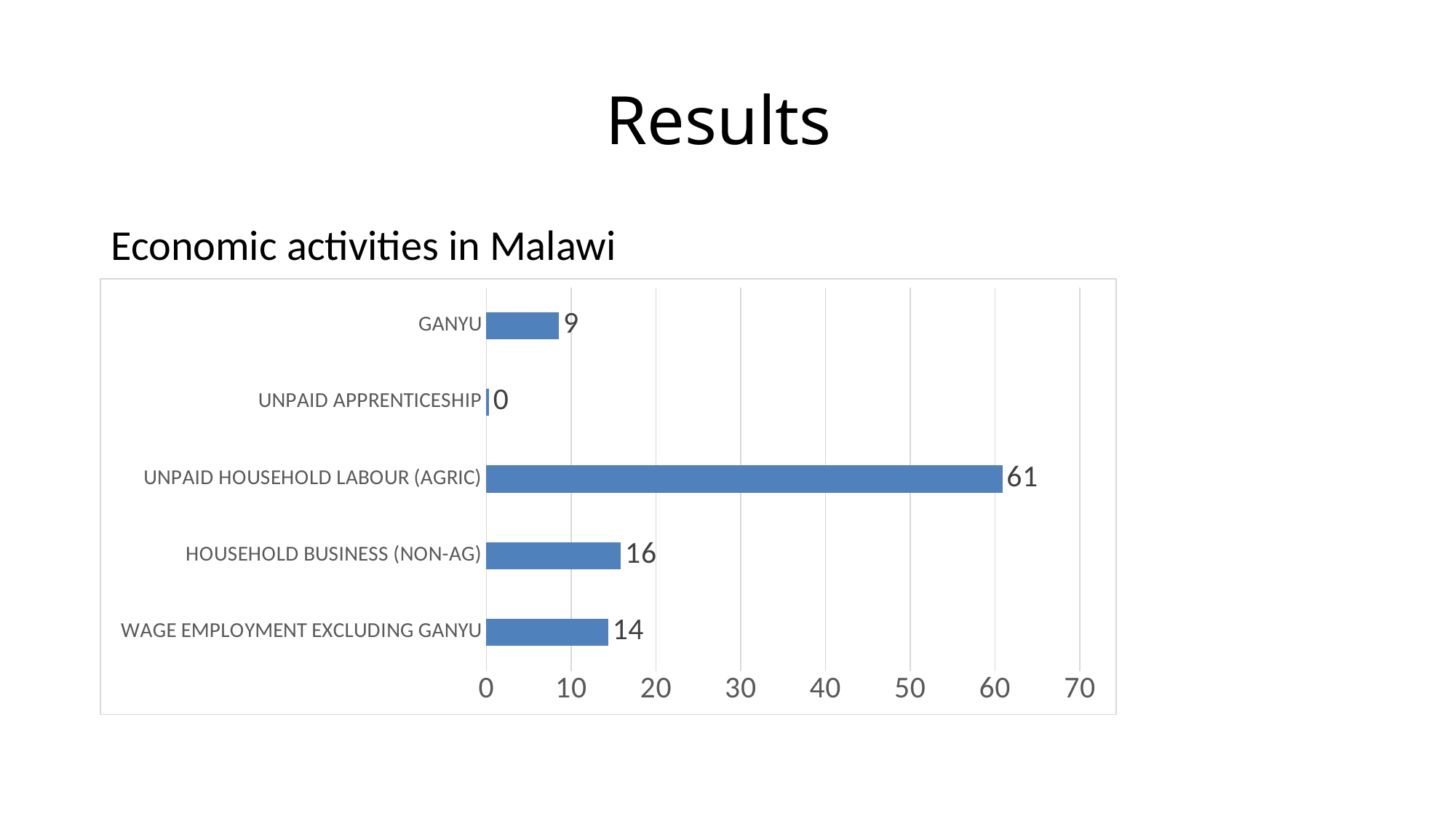
What is the value for Wage employment excluding ganyu? 14 Which category has the lowest value? Unpaid apprenticeship Is the value for Unpaid household labour (agric) greater or less than 50? greater What is the value for Ganyu? 9 What is the difference between the values for Unpaid household labour (agric) and Household business (non-ag)? 45 What is the title of the chart? Economic activities in Malawi What is the value for Household business (non-ag)? 16 What kind of chart is shown on the slide? Bar chart Which category has the highest value? Unpaid household labour (agric) How many categories are shown in the chart? 5 What is the value for Unpaid household labour (agric)? 61 Which is larger, the value for Household business (non-ag) or the value for Wage employment excluding ganyu? Household business (non-ag)